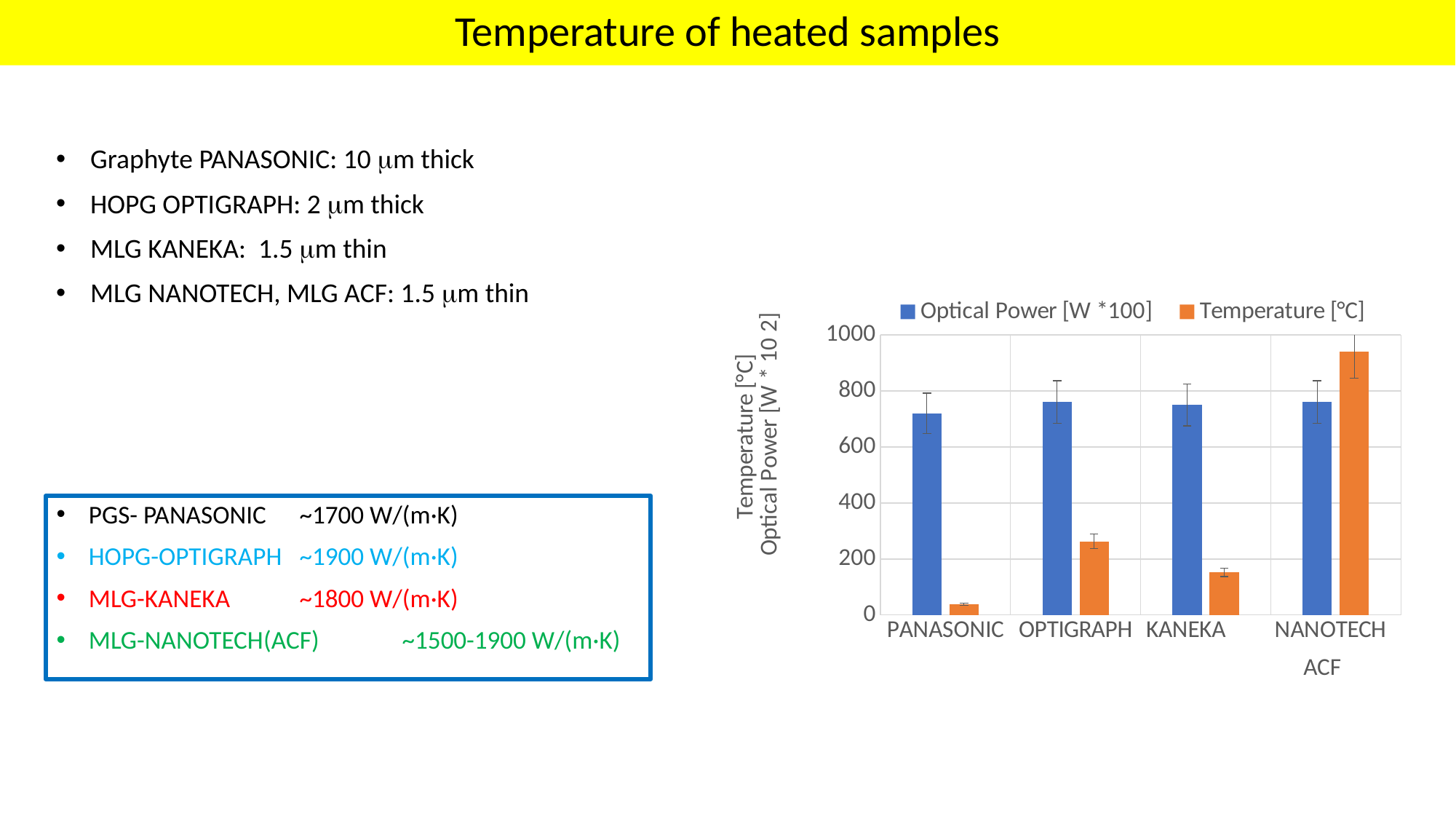
Is the Temperature [°C] value for OPTIGRAPH greater or less than 200? greater Which sample has the lowest Temperature [°C] in the chart? PANASONIC Which sample has the highest Temperature [°C] in the chart? NANOTECH ACF What kind of chart is shown on the slide? bar chart Which is larger, the Temperature [°C] for OPTIGRAPH or for KANEKA? OPTIGRAPH How many sample categories are shown on the x axis of the chart? 4 Is the Optical Power [W *100] value for PANASONIC greater or less than 600? greater How many series does the chart legend list? 2 What colour are the Temperature [°C] bars in the chart? orange Is the Temperature [°C] value for NANOTECH ACF greater or less than 800? greater For NANOTECH ACF, which bar is taller: Optical Power [W *100] or Temperature [°C]? Temperature [°C]